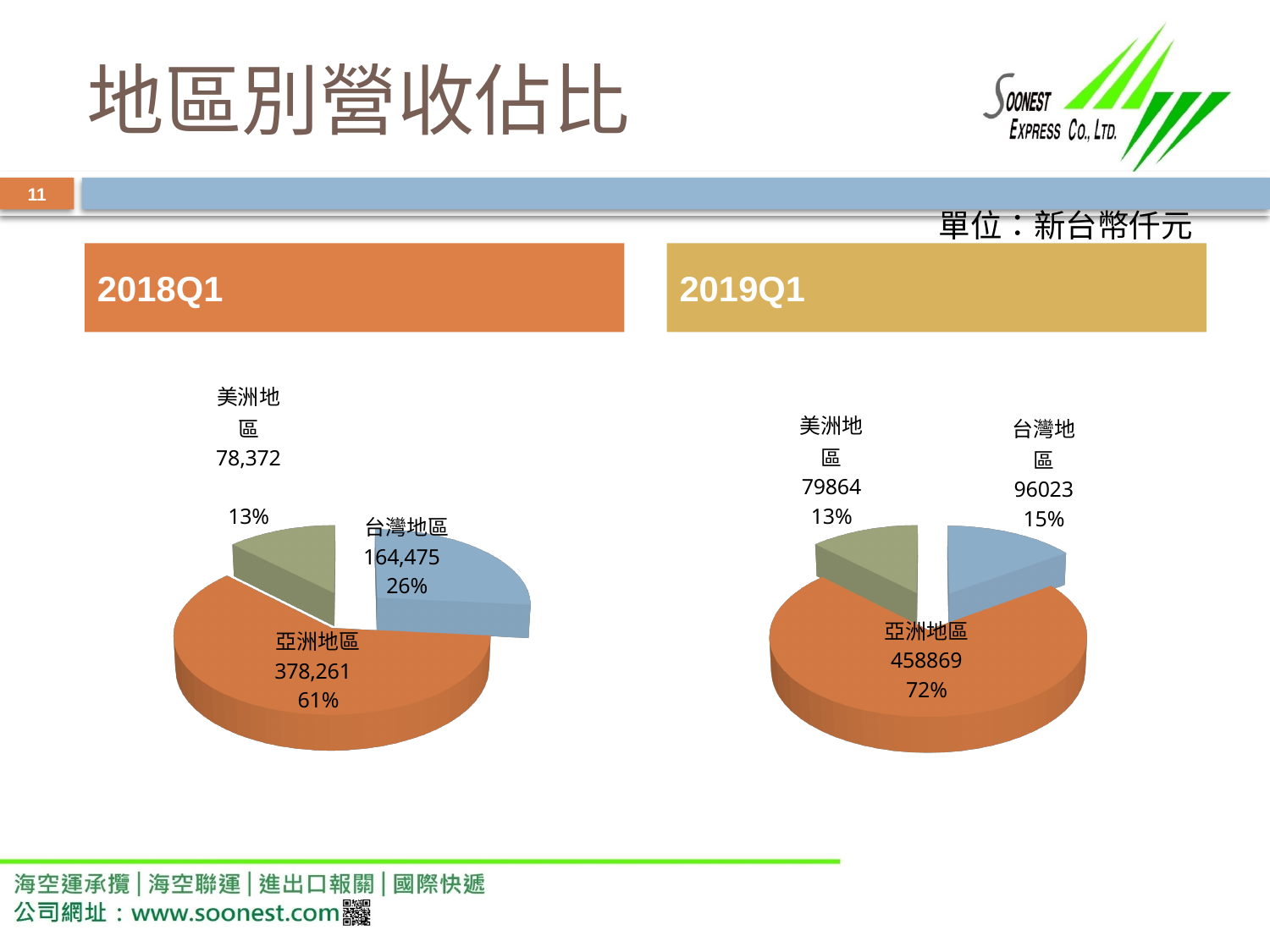
In the 2019Q1 pie chart, what is the value for 美洲地區? 79864 What unit is stated for the values on the slide? 新台幣仟元 In the 2018Q1 pie chart, what share does 台灣地區 have? 26% How many slices does the 2019Q1 pie chart have? 3 What kind of chart is used for 2018Q1? Pie chart In the 2018Q1 pie chart, which region has the largest slice? 亞洲地區 In the 2018Q1 pie chart, what is the value for 亞洲地區? 378,261 In the 2019Q1 pie chart, what is the value for 台灣地區? 96023 In the 2019Q1 pie chart, which region has the smallest slice? 美洲地區 In the 2019Q1 pie chart, what share does 亞洲地區 have? 72% In the 2018Q1 pie chart, what is the difference between the values for 台灣地區 and 美洲地區? 86,103 In the 2019Q1 pie chart, which is larger, the value for 台灣地區 or 美洲地區? 台灣地區